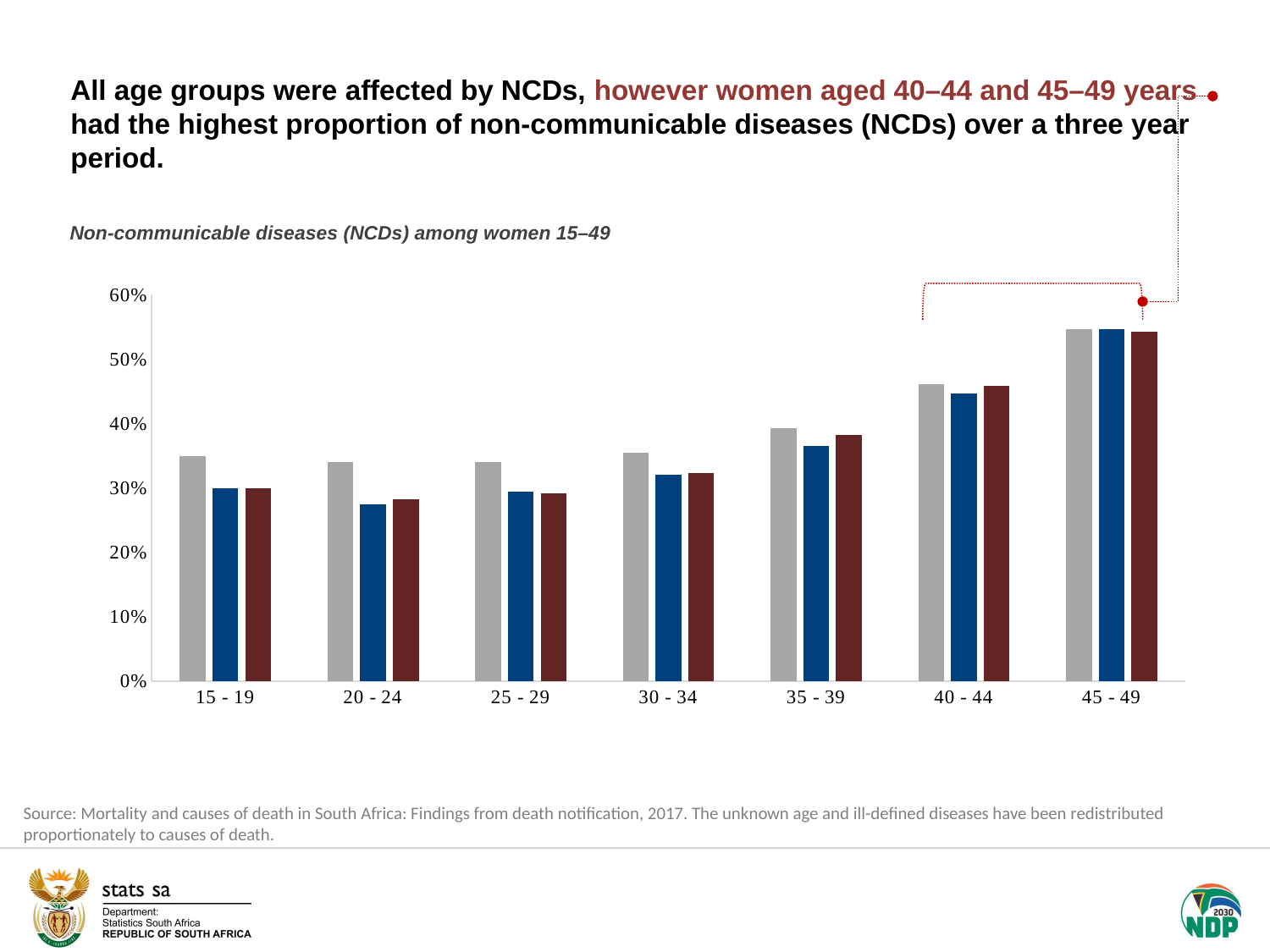
Which is larger: the grey bar for 35 - 39 or the grey bar for 25 - 29? 35 - 39 Which age group has the highest bars in the chart? 45 - 49 What is the title of the chart? Non-communicable diseases (NCDs) among women 15–49 Is the value of the grey bar for the 15 - 19 age group greater or less than 40%? less Which age group has the lowest blue bar? 20 - 24 Is the value of the blue bar for the 35 - 39 age group greater or less than 30%? greater Is the value of the grey bar for the 45 - 49 age group greater or less than 50%? greater What type of chart is shown on the slide? Bar chart How many age groups are shown on the x axis of the chart? 7 Do the values generally rise or fall from the 25 - 29 age group to the 45 - 49 age group? rise